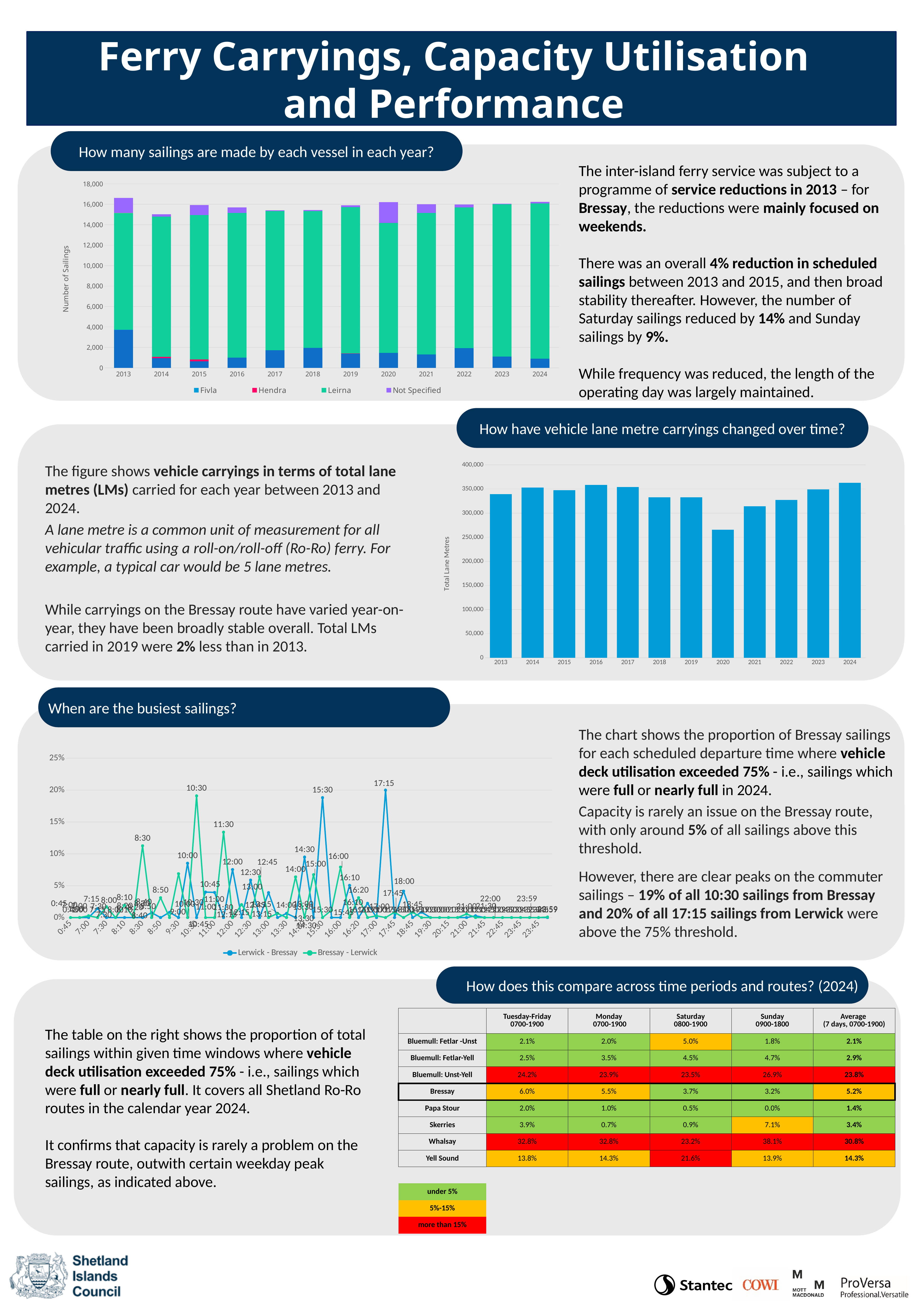
In the 'How have vehicle lane metre carryings changed over time?' chart, is the value for 2024 greater or less than 350,000? greater In the 'When are the busiest sailings?' chart, which two series does the legend list? Lerwick - Bressay and Bressay - Lerwick In the 'How many sailings are made by each vessel in each year?' chart, how many series does the legend list? 4 In the 'How have vehicle lane metre carryings changed over time?' chart, is the value for 2020 greater or less than 300,000? less In the 'How many sailings are made by each vessel in each year?' chart, which vessel accounts for the largest share of sailings in every year? Leirna In the 'How many sailings are made by each vessel in each year?' chart, how many years are shown on the x axis? 12 What kind of chart is used in the 'How many sailings are made by each vessel in each year?' section? Stacked bar chart In the 'How many sailings are made by each vessel in each year?' chart, is the total number of sailings in 2013 greater or less than 16,000? greater What kind of chart is used in the 'When are the busiest sailings?' section? Line chart In the 'How have vehicle lane metre carryings changed over time?' chart, which is larger: the value for 2016 or the value for 2020? 2016 In the 'How have vehicle lane metre carryings changed over time?' chart, which year has the lowest total lane metres? 2020